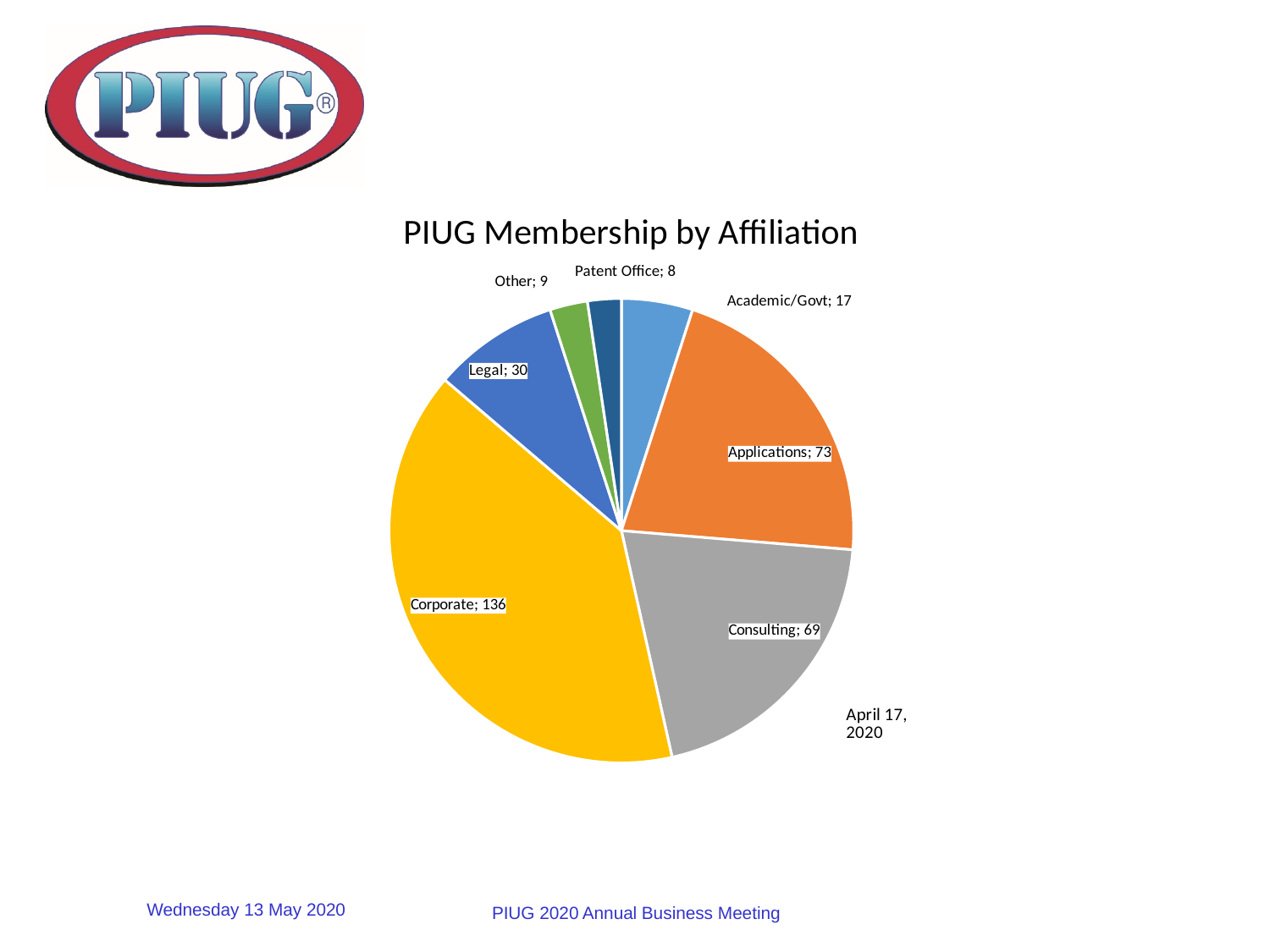
What date is noted next to the pie chart? April 17, 2020 What is the value for Legal? 30 What kind of chart is shown on the slide? pie chart Which affiliation has the smallest slice of the pie? Patent Office Which affiliation has the largest slice of the pie? Corporate What is the total membership across all affiliations shown in the pie chart? 342 How many affiliation categories are shown in the pie chart? 7 What is the value for Corporate? 136 What is the title of the chart? PIUG Membership by Affiliation What is the value for Academic/Govt? 17 What is the difference between the Applications and Consulting values? 4 Which is larger, Applications or Consulting? Applications